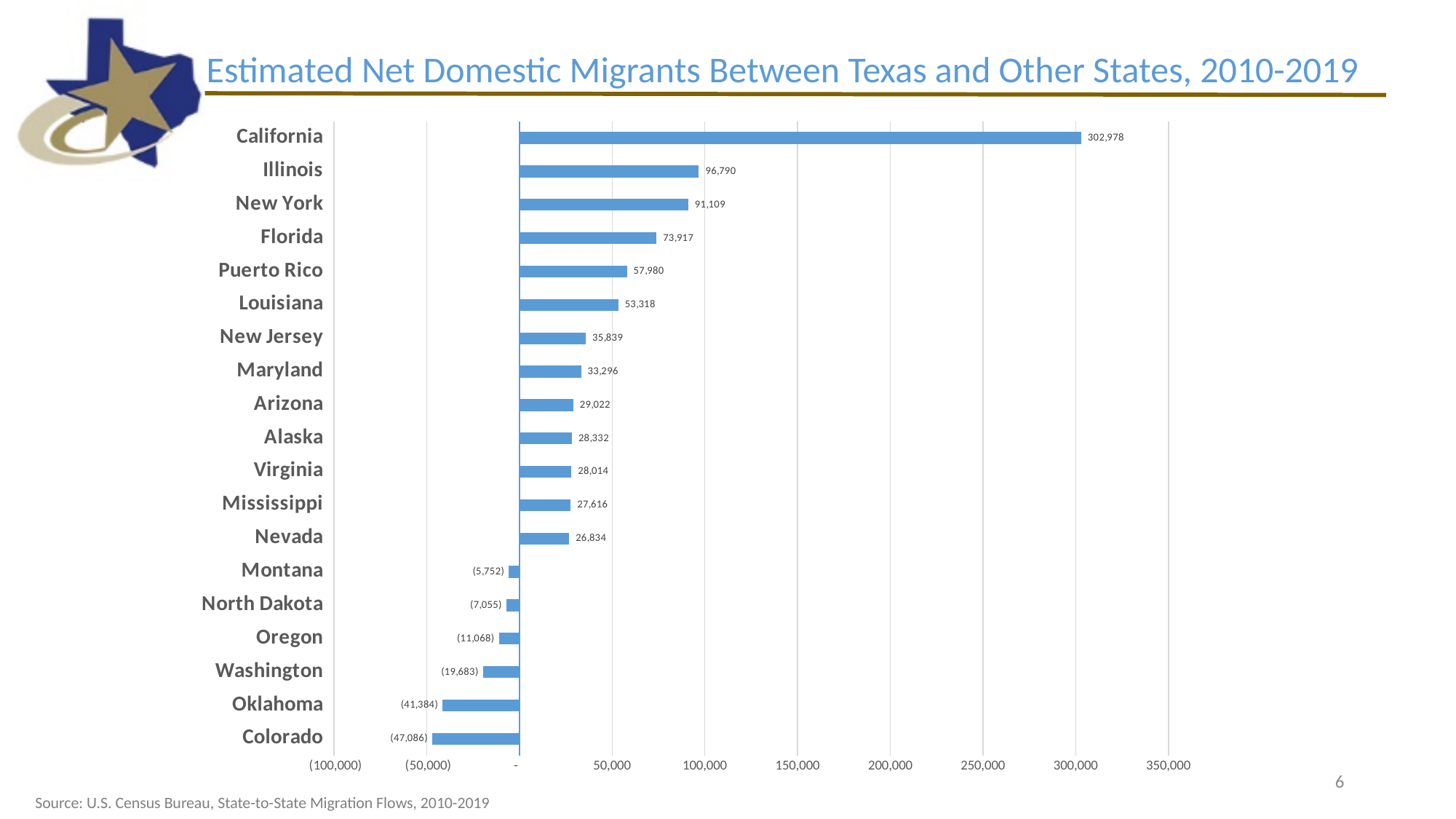
Which state has the lowest (most negative) value on the chart? Colorado How many states or territories are shown on the chart? 19 What is the source cited for the chart data? U.S. Census Bureau, State-to-State Migration Flows, 2010-2019 How many categories on the chart have negative values? 6 What is the difference between the values for Illinois and New York? 5,681 Which state has the highest net domestic migration to Texas? California Is the value for New York greater or less than 100,000? less What type of chart is shown on the slide? Bar chart What is the value shown for Puerto Rico? 57,980 What is the estimated net domestic migration value for California? 302,978 Which has a larger value, Florida or Louisiana? Florida What is the value shown for Colorado? (47,086)